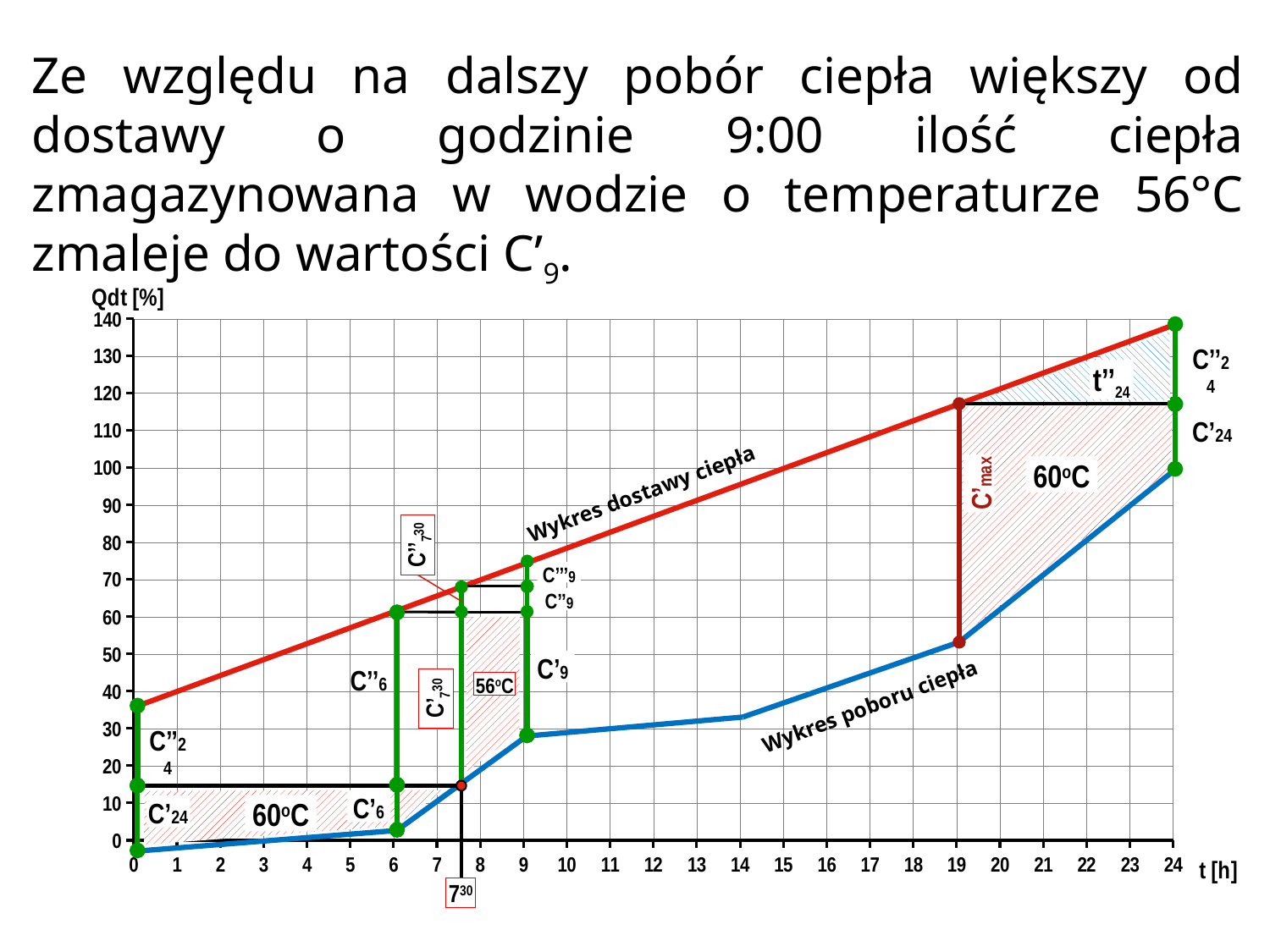
Is the value of the blue line (Wykres poboru ciepła) at t = 24 greater or less than 90? greater Does the blue line (Wykres poboru ciepła) rise or fall as t increases from 0 to 24? rise Is the value of the blue line (Wykres poboru ciepła) at t = 19 greater or less than 60? less What is the label of the vertical axis of the chart? Qdt [%] How many lines (series) are plotted on the chart? 2 Is the value of the red line (Wykres dostawy ciepła) at t = 24 greater or less than 130? greater What is the label on the red line of the chart? Wykres dostawy ciepła Does the red line (Wykres dostawy ciepła) rise or fall as t increases from 0 to 24? rise At t = 9, which line has the higher value, Wykres dostawy ciepła or Wykres poboru ciepła? Wykres dostawy ciepła What kind of chart is shown on the slide? line chart